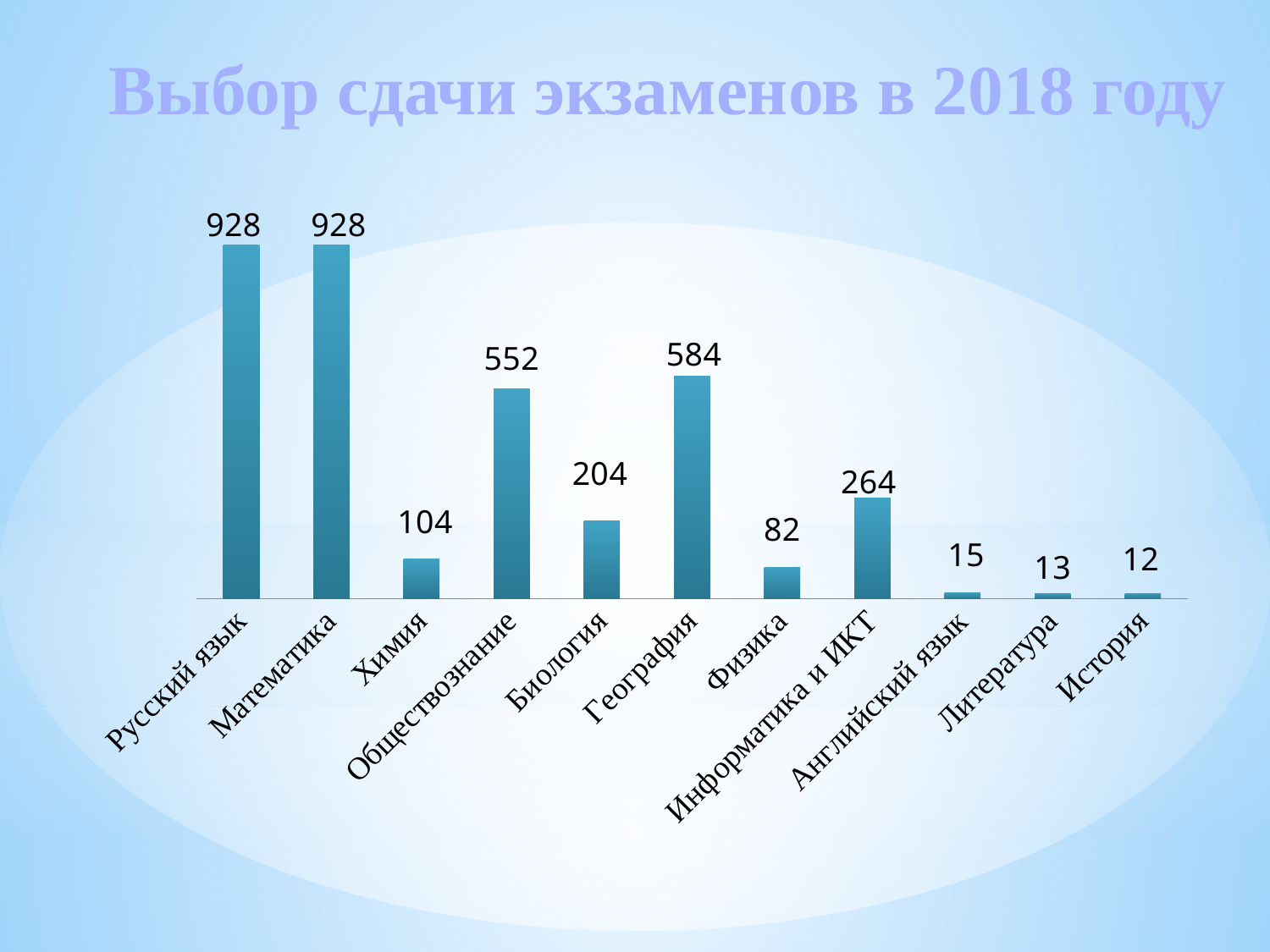
Which is larger, the value for Биология or the value for Физика? Биология What is the value for Химия? 104 What is the value for Информатика и ИКТ? 264 How many categories are shown on the chart? 11 What is the value for Обществознание? 552 What is the difference between the values for Русский язык and Биология? 724 Which category has the lowest value? История What is the value for География? 584 What is the title of the slide? Выбор сдачи экзаменов в 2018 году What kind of chart is shown on the slide? Bar chart What is the difference between the values for География and Обществознание? 32 What is the value for Английский язык? 15